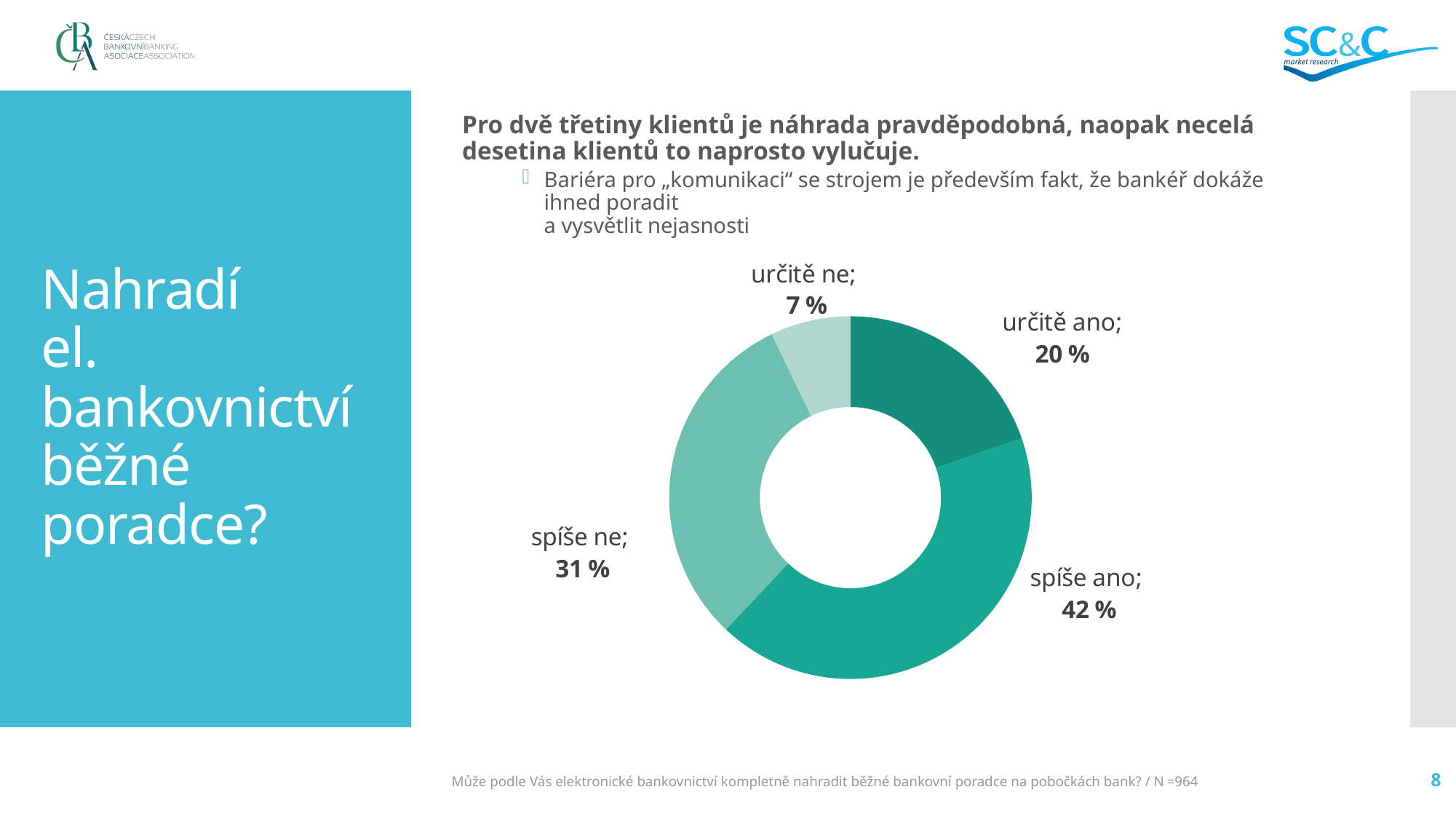
What is the sample size (N) stated in the footnote below the chart? 964 Which answer category has the largest share of the chart? spíše ano What is the difference in percentage points between "spíše ano" and "spíše ne"? 11 How many categories are shown in the chart? 4 Which answer category has the smallest share of the chart? určitě ne What percentage of respondents answered "spíše ano"? 42 % What kind of chart is shown on the slide? doughnut chart What percentage of respondents answered "určitě ano"? 20 % What is the combined share of "určitě ano" and "spíše ano"? 62 % Which is larger, the share for "určitě ano" or the share for "spíše ne"? spíše ne What percentage of respondents answered "spíše ne"? 31 % What percentage of respondents answered "určitě ne"? 7 %